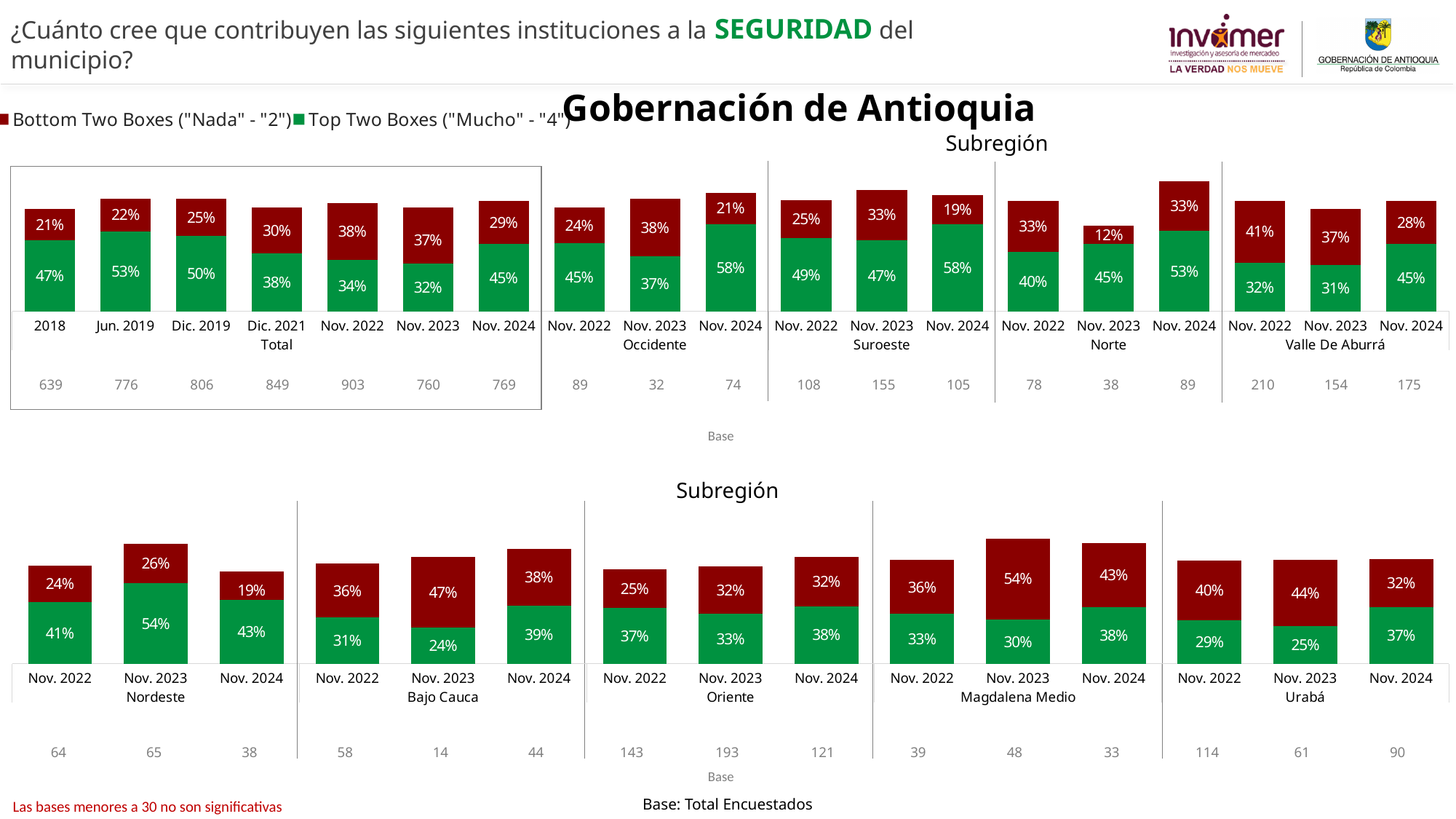
In the top chart, does the Top Two Boxes value for Suroeste rise or fall from Nov. 2023 to Nov. 2024? Rise In the top chart, how many bars are shown in the Total section? 7 In the top chart, what is the difference between the Top Two Boxes and Bottom Two Boxes values for Occidente in Nov. 2024? 37% What type of chart is the bottom chart? Stacked bar chart How many series does the legend list? 2 In the top chart, what is the Bottom Two Boxes value for Norte in Nov. 2023? 12% In the bottom chart, which is larger for Urabá in Nov. 2024: the Top Two Boxes value or the Bottom Two Boxes value? Top Two Boxes In the top chart, which Total period has the highest Top Two Boxes value? Jun. 2019 In the top chart, what is the combined total of the Bottom Two Boxes and Top Two Boxes values for Valle De Aburrá in Nov. 2022? 73% In the top chart, what is the Top Two Boxes value for Total in Nov. 2024? 45% In the bottom chart, what is the Bottom Two Boxes value for Magdalena Medio in Nov. 2023? 54% In the bottom chart, which Bajo Cauca period has the lowest Top Two Boxes value? Nov. 2023